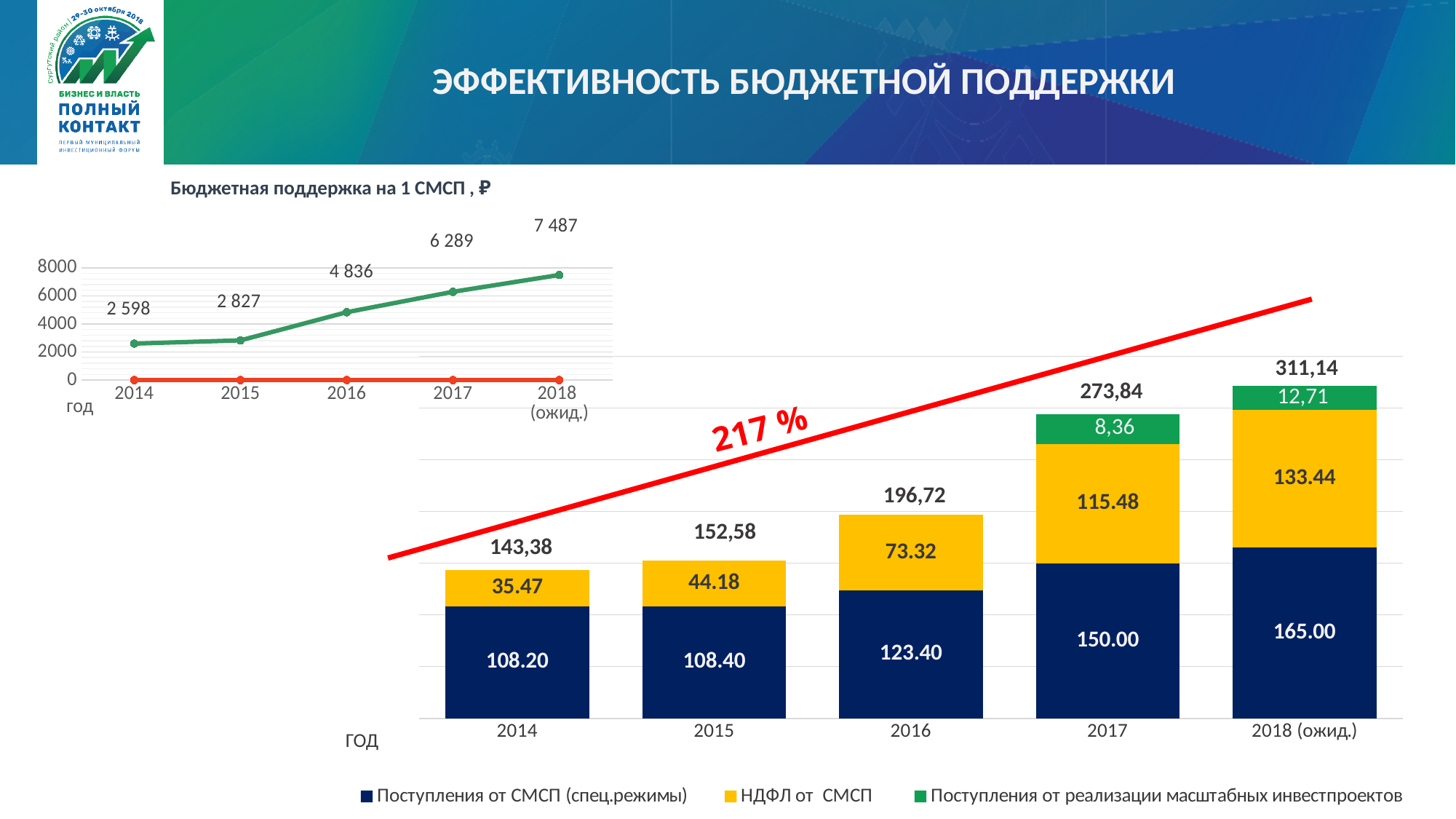
In the stacked bar chart on the right, which year has the highest total? 2018 (ожид.) In the line chart titled 'Бюджетная поддержка на 1 СМСП , ₽', which year has the lowest value on the green line? 2014 In the line chart titled 'Бюджетная поддержка на 1 СМСП , ₽', what is the value for 2018 (ожид.)? 7 487 In the line chart titled 'Бюджетная поддержка на 1 СМСП , ₽', what is the value for 2016? 4 836 In the stacked bar chart on the right, what is the difference between the 'НДФЛ от СМСП' values for 2018 (ожид.) and 2017? 17.96 In the stacked bar chart on the right, what is the value of 'Поступления от СМСП (спец.режимы)' for 2018 (ожид.)? 165.00 In the stacked bar chart on the right, how many series does the legend list? 3 In the line chart titled 'Бюджетная поддержка на 1 СМСП , ₽', do the values on the green line rise or fall from 2014 to 2018? rise What kind of chart is the chart on the right side of the slide? stacked bar chart In the line chart titled 'Бюджетная поддержка на 1 СМСП , ₽', what is the difference between the 2017 and 2016 values? 1 453 In the stacked bar chart on the right, what is the value of 'НДФЛ от СМСП' for 2016? 73.32 In the stacked bar chart on the right, what is the total of the stacked bar for 2017? 273,84